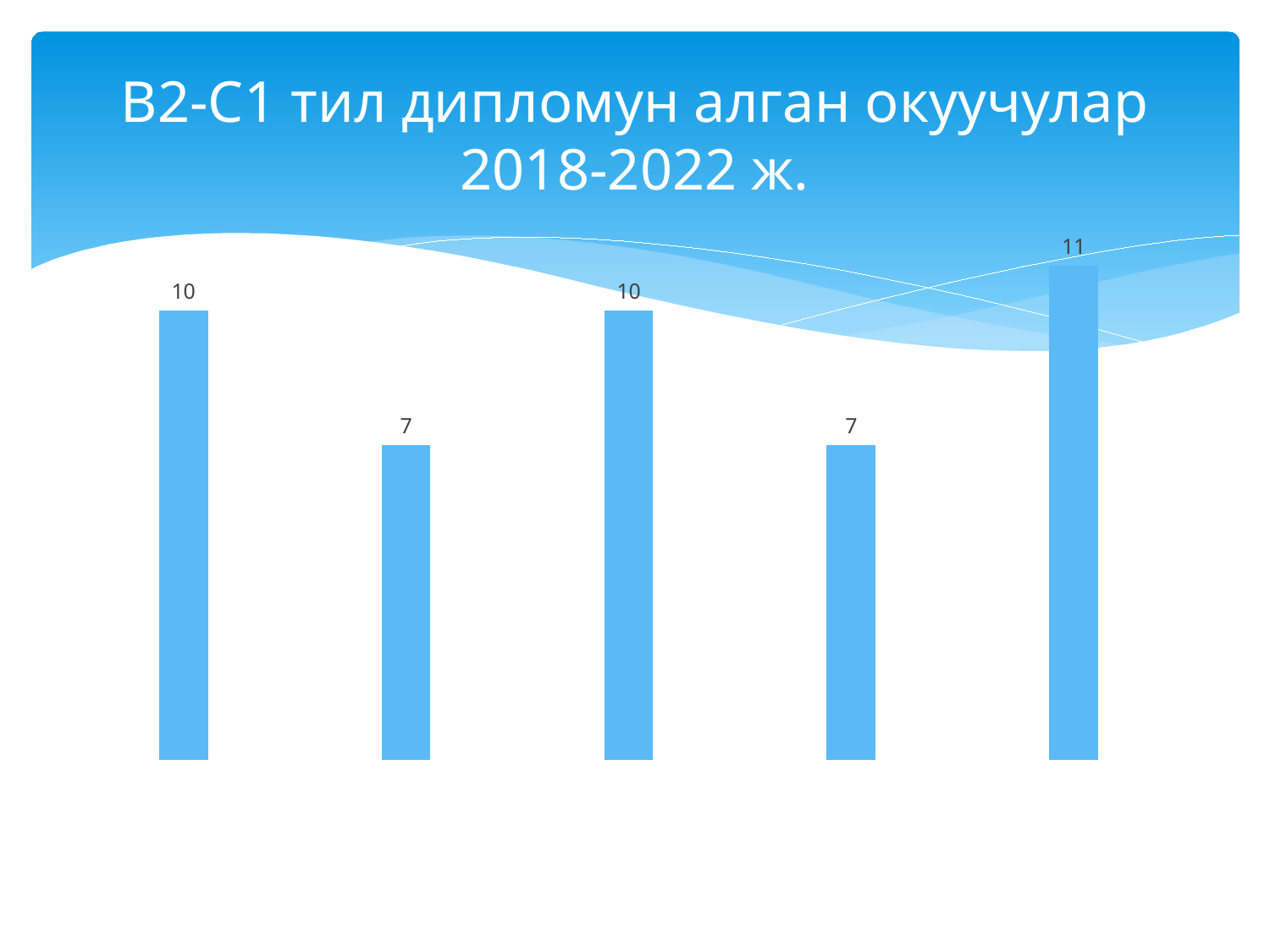
What is the value of the last (rightmost) bar? 11 What is the title of the slide containing the chart? B2-C1 тил дипломун алган окуучулар 2018-2022 ж. How many bars does the chart contain? 5 What is the value of the second bar from the left? 7 What kind of chart is shown on the slide? bar chart Which bar has the highest value? the rightmost (fifth) bar, 11 What is the value of the first (leftmost) bar? 10 What is the value of the fourth bar from the left? 7 What is the difference between the rightmost bar and the second bar from the left? 4 Which is larger, the first bar or the second bar? the first bar What is the difference between the first bar and the last bar? 1 What is the lowest value shown on the chart? 7